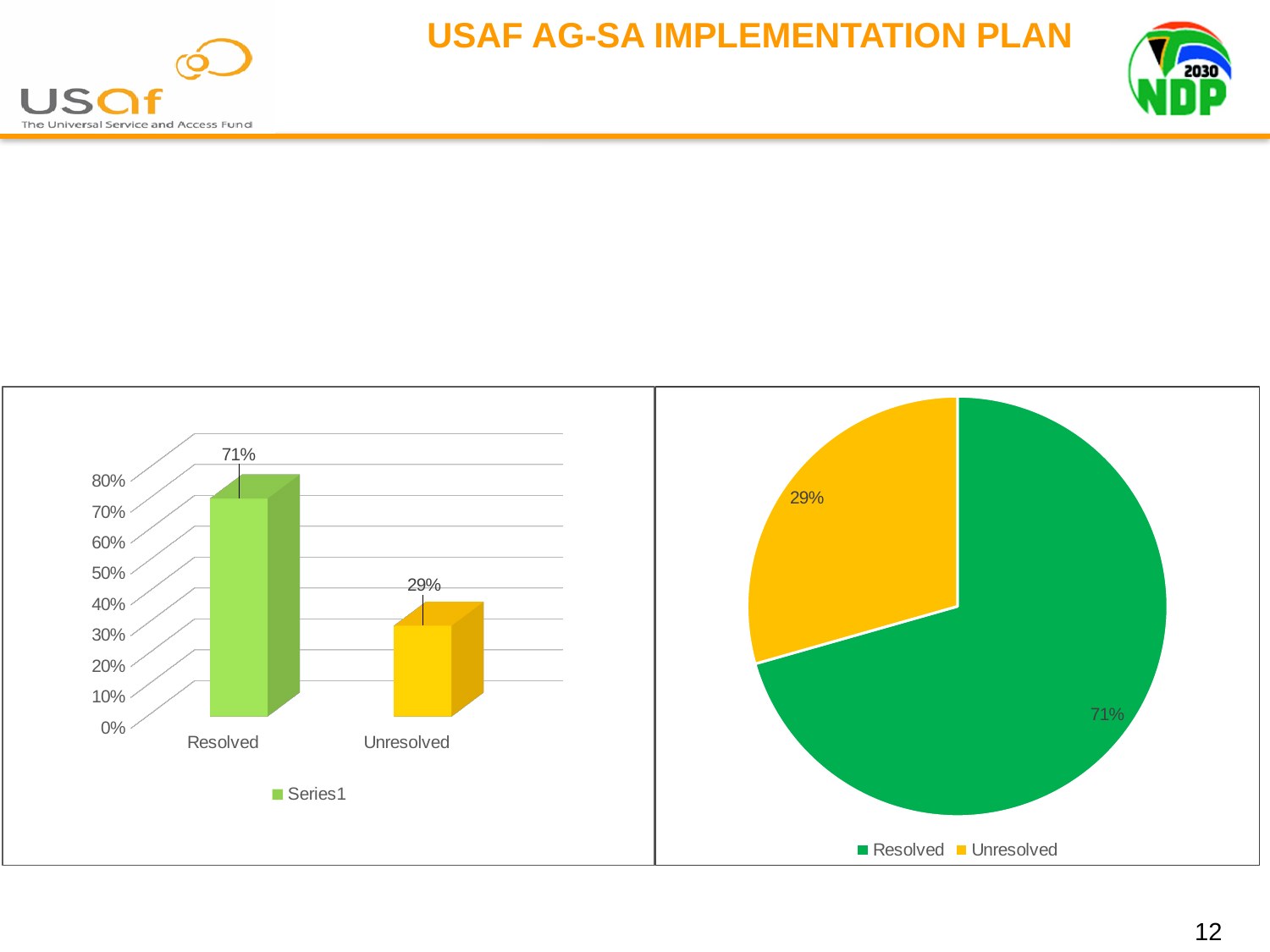
What kind of chart is shown on the right of the slide? Pie chart In the bar chart on the left, what is the value for Unresolved? 29% In the pie chart on the right, what share does the Resolved slice have? 71% In the bar chart on the left, which category has the highest value? Resolved In the bar chart on the left, how many series does the legend list? 1 In the bar chart on the left, how many categories are shown on the x axis? 2 In the bar chart on the left, what is the difference between the Resolved and Unresolved values? 42% In the bar chart on the left, what is the value for Resolved? 71% In the bar chart on the left, which category has the lowest value? Unresolved What kind of chart is shown on the left of the slide? Bar chart In the pie chart on the right, which slice is larger, Resolved or Unresolved? Resolved In the pie chart on the right, what share does the Unresolved slice have? 29%